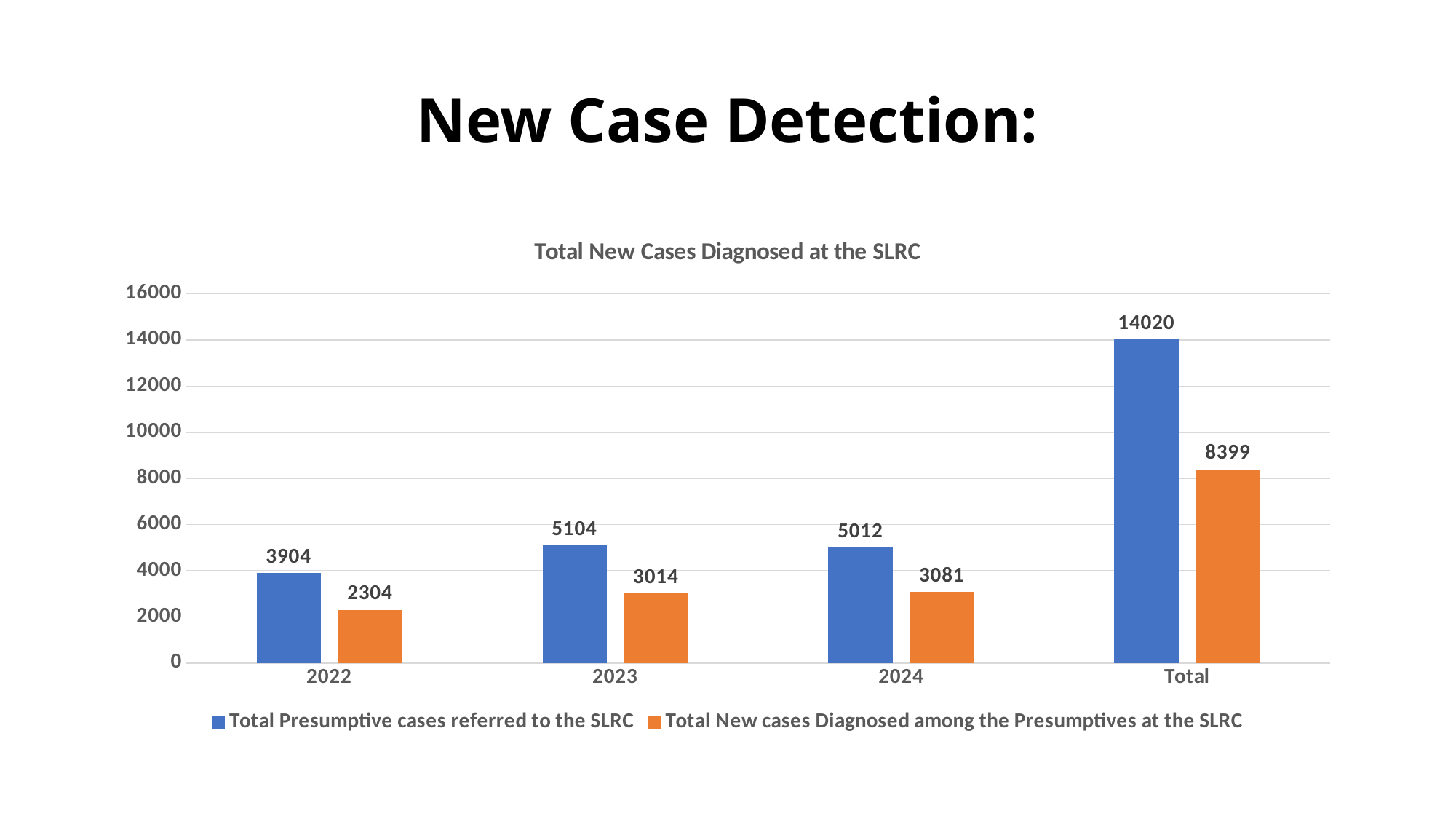
Is the Total value for Total New cases Diagnosed among the Presumptives at the SLRC greater or less than 8000? greater How many categories are shown on the x axis of the chart? 4 What is the Total value for Total Presumptive cases referred to the SLRC? 14020 What is the value of Total New cases Diagnosed among the Presumptives at the SLRC for 2024? 3081 Among the years 2022, 2023 and 2024, which year has the highest number of Total Presumptive cases referred to the SLRC? 2023 What is the title of the chart? Total New Cases Diagnosed at the SLRC Among the years 2022, 2023 and 2024, which year has the lowest number of Total New cases Diagnosed among the Presumptives at the SLRC? 2022 What is the difference between Total Presumptive cases referred to the SLRC and Total New cases Diagnosed among the Presumptives at the SLRC in 2023? 2090 What is the value of Total Presumptive cases referred to the SLRC for 2022? 3904 What kind of chart is shown on the slide? bar chart Which is larger: Total New cases Diagnosed among the Presumptives at the SLRC in 2023 or in 2024? 2024 How many series does the legend list? 2